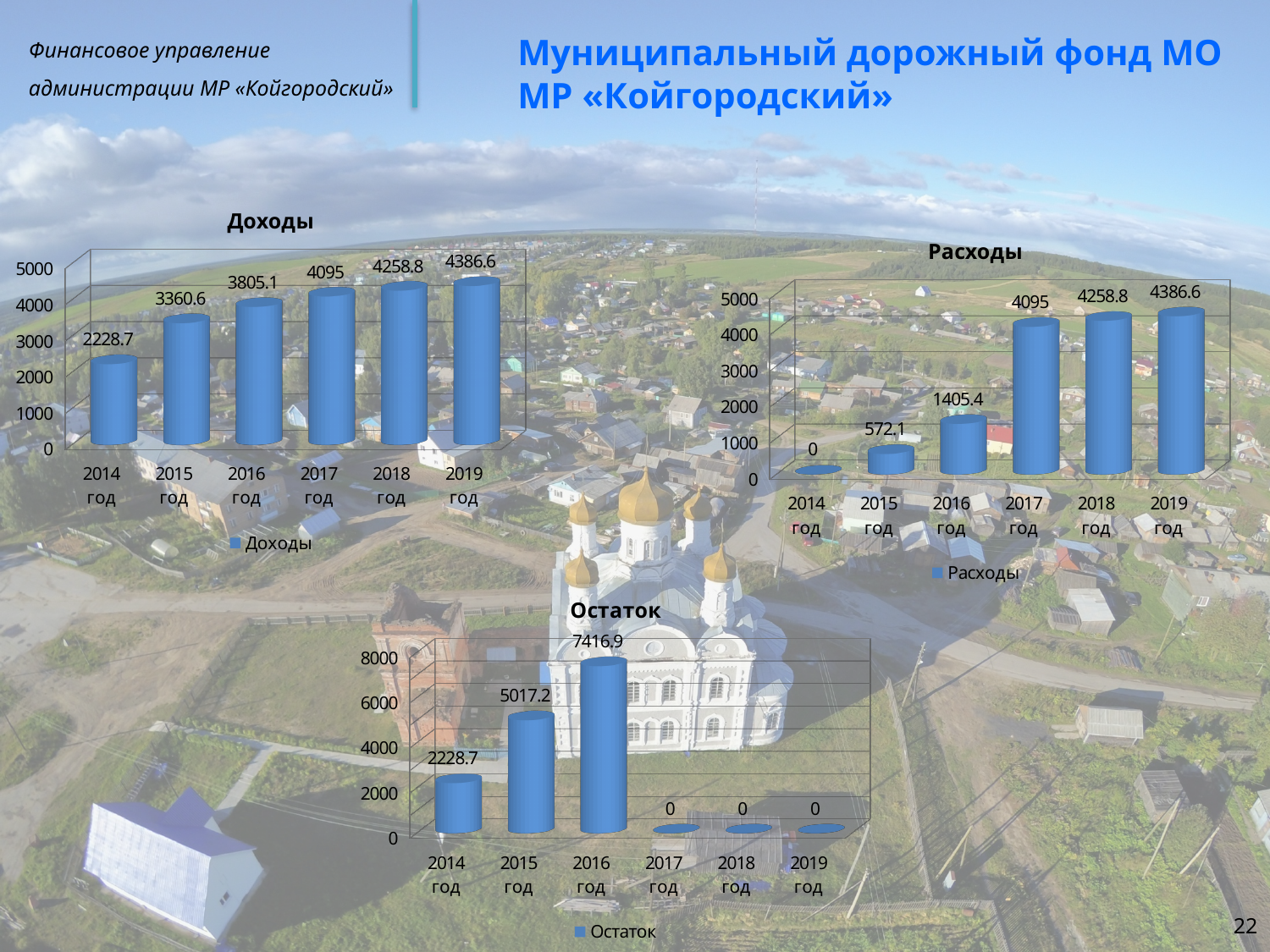
In the 'Расходы' chart, what is the difference between the values for 2017 год and 2016 год? 2689.6 How many charts are shown on the slide? 3 In the 'Остаток' chart, which year has the highest value? 2016 год In the 'Остаток' chart, what is the value for 2016 год? 7416.9 In the 'Остаток' chart, which is larger, the value for 2015 год or 2014 год? 2015 год In the 'Доходы' chart, what is the value for 2015 год? 3360.6 In the 'Доходы' chart, do the values rise or fall from 2014 to 2019? rise In the 'Доходы' chart, which year has the lowest value? 2014 год In the 'Расходы' chart, what is the value for 2014 год? 0 In the 'Расходы' chart, what is the value for 2016 год? 1405.4 In the 'Доходы' chart, what is the difference between the values for 2019 год and 2014 год? 2157.9 In the 'Расходы' chart, which year has the highest value? 2019 год